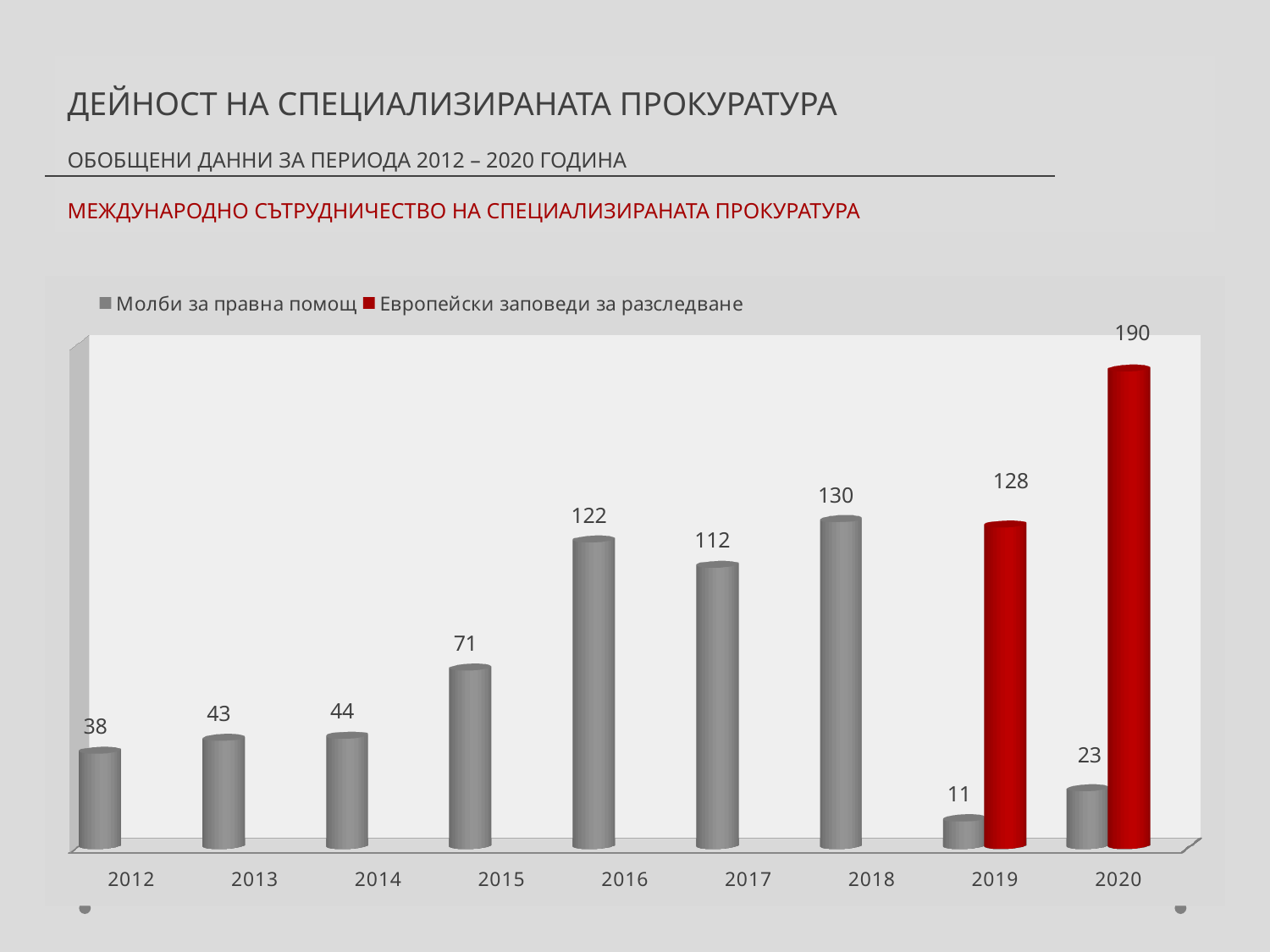
What is the difference between Европейски заповеди за разследване in 2020 and in 2019? 62 How many series does the legend list? 2 In which year is Молби за правна помощ lowest? 2019 What is the value for Европейски заповеди за разследване in 2020? 190 What is the value for Молби за правна помощ in 2019? 11 Which is larger: Молби за правна помощ in 2017 or in 2018? 2018 What is the value for Молби за правна помощ in 2016? 122 Do the values for Молби за правна помощ rise or fall from 2012 to 2015? rise What kind of chart is shown on the slide? bar chart How many years are shown on the x axis? 9 In which year is Молби за правна помощ highest? 2018 What colour are the bars for Европейски заповеди за разследване? red